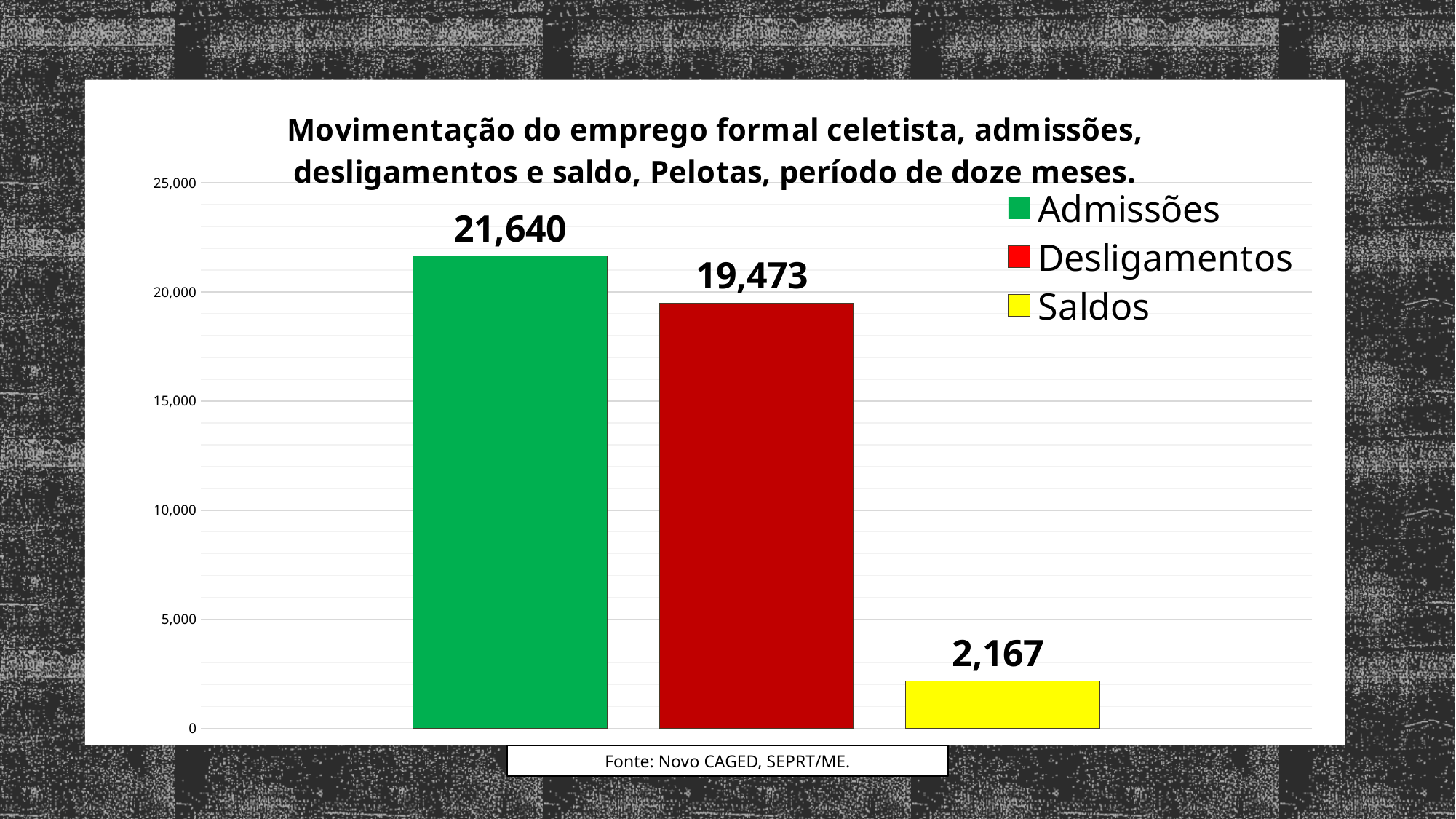
What colour is the Saldos bar? yellow Which is larger, Desligamentos or Saldos? Desligamentos How many series does the legend list? 3 Which series has the lowest value? Saldos What is the value for Saldos? 2,167 Which series has the highest value? Admissões What is the difference between Admissões and Desligamentos? 2,167 What kind of chart is shown? bar chart What is the value for Admissões? 21,640 What is the value for Desligamentos? 19,473 Is the value for Desligamentos greater or less than 20,000? less How many bars are plotted on the chart? 3